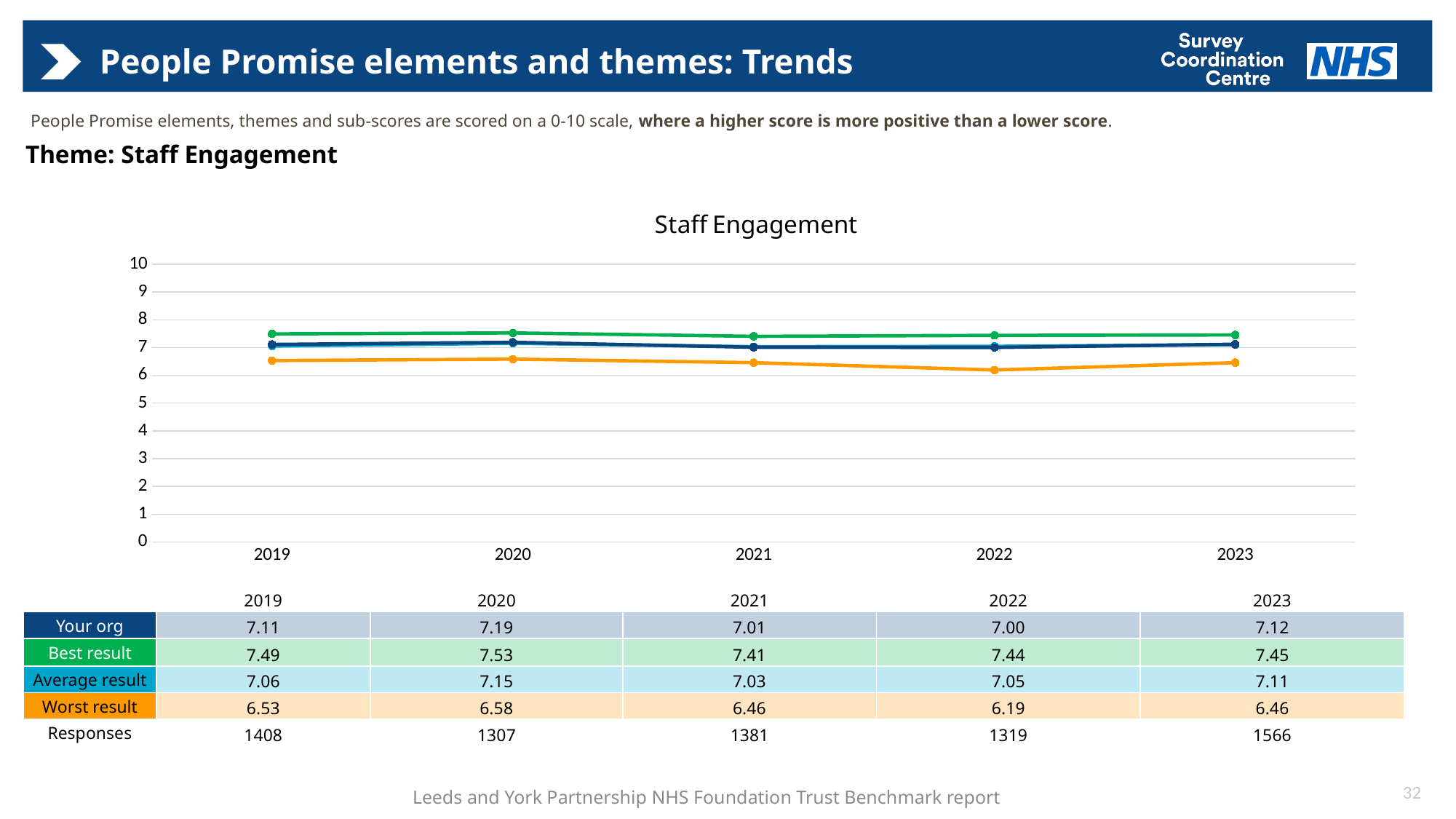
Is the Worst result for Staff Engagement in 2022 greater or less than 7? less How many series are plotted in the Staff Engagement chart? 4 Which is larger in 2019: the Your org score or the Average result for Staff Engagement? Your org How many years are shown on the x axis of the Staff Engagement chart? 5 What is the difference between the Best result and the Worst result for Staff Engagement in 2022? 1.25 What is the Best result for Staff Engagement in 2021? 7.41 What is the Your org score for Staff Engagement in 2020? 7.19 In which year was the Best result for Staff Engagement highest? 2020 What is the Average result for Staff Engagement in 2023? 7.11 In which year was the Your org score for Staff Engagement lowest? 2022 What is the Worst result for Staff Engagement in 2022? 6.19 What type of chart is the Staff Engagement chart? Line chart